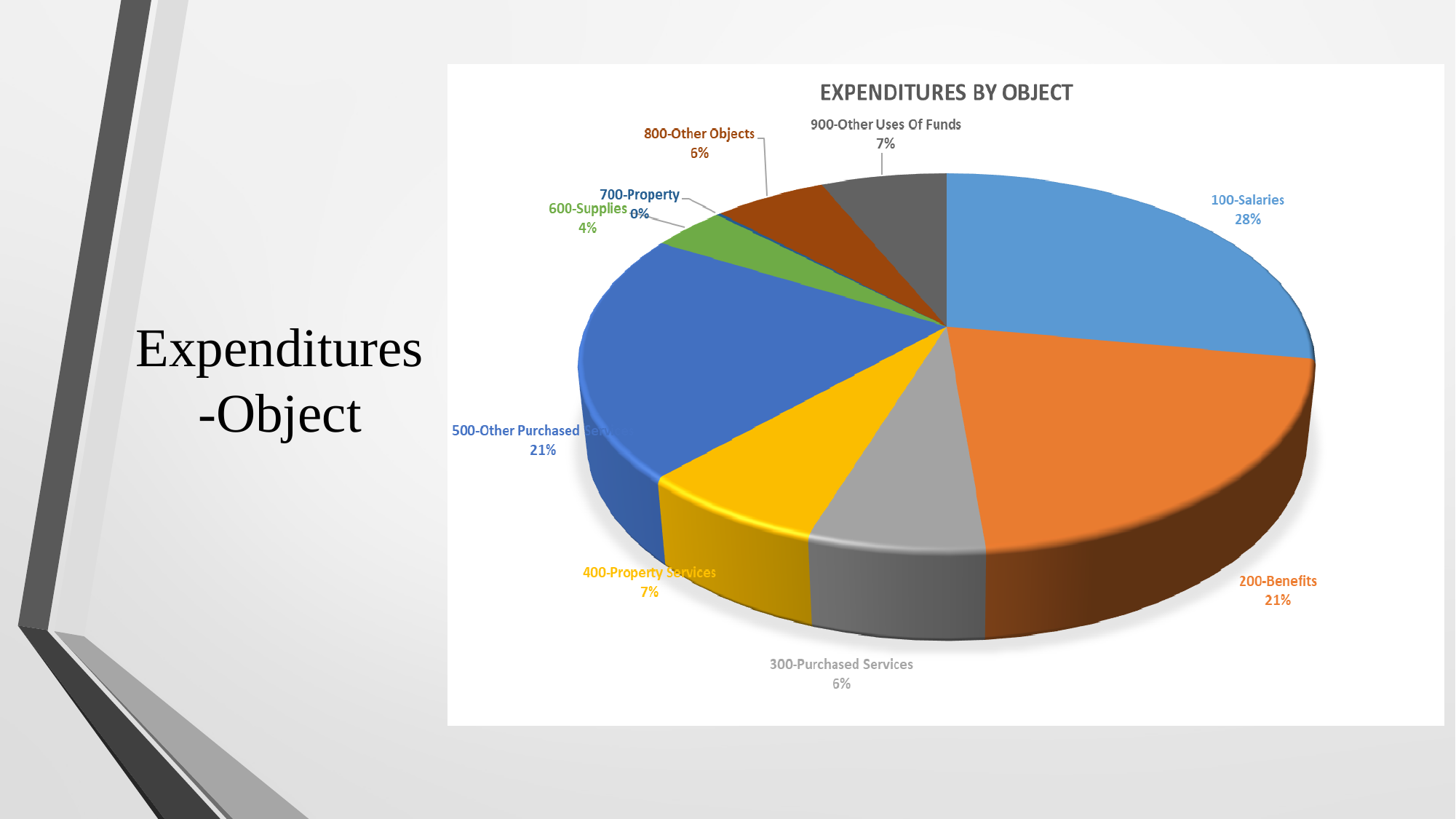
What is the title of the chart? EXPENDITURES BY OBJECT What share of expenditures is 100-Salaries? 28% Which category has the smallest share of expenditures? 700-Property What is the combined share of 800-Other Objects and 900-Other Uses Of Funds? 13% What percentage is shown for 600-Supplies? 4% What type of chart is shown on the slide? Pie chart Which is larger, 400-Property Services or 300-Purchased Services? 400-Property Services Which category has the largest share of expenditures? 100-Salaries What percentage is shown for 200-Benefits? 21% What is the difference in percentage points between 100-Salaries and 200-Benefits? 7 What percentage is shown for 900-Other Uses Of Funds? 7% How many categories are shown in the pie chart? 9